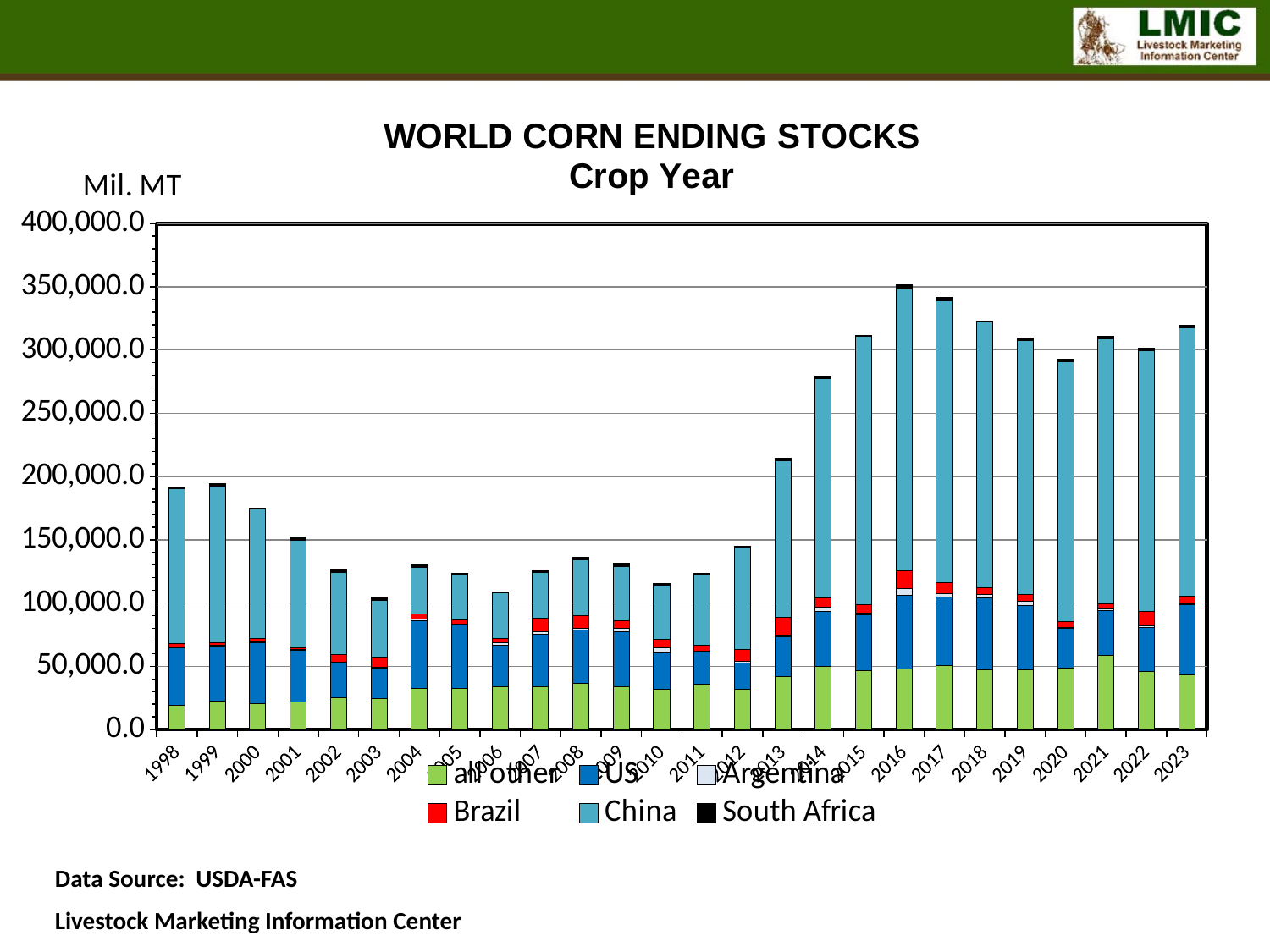
What unit is shown on the y axis of the chart? Mil. MT Is the total for 2000 greater or less than 200,000.0? less How many crop years are plotted along the x axis? 26 Which crop year has the highest total world corn ending stocks? 2016 How many series does the legend list? 6 Which crop year has a larger total, 2016 or 2018? 2016 Do total world corn ending stocks rise or fall from 2013 to 2016? rise Is the total for 2016 greater or less than 300,000.0? greater Is the total for 2014 greater or less than 250,000.0? greater Which crop year has the lowest total world corn ending stocks? 2003 What kind of chart is shown on the slide? Stacked bar chart